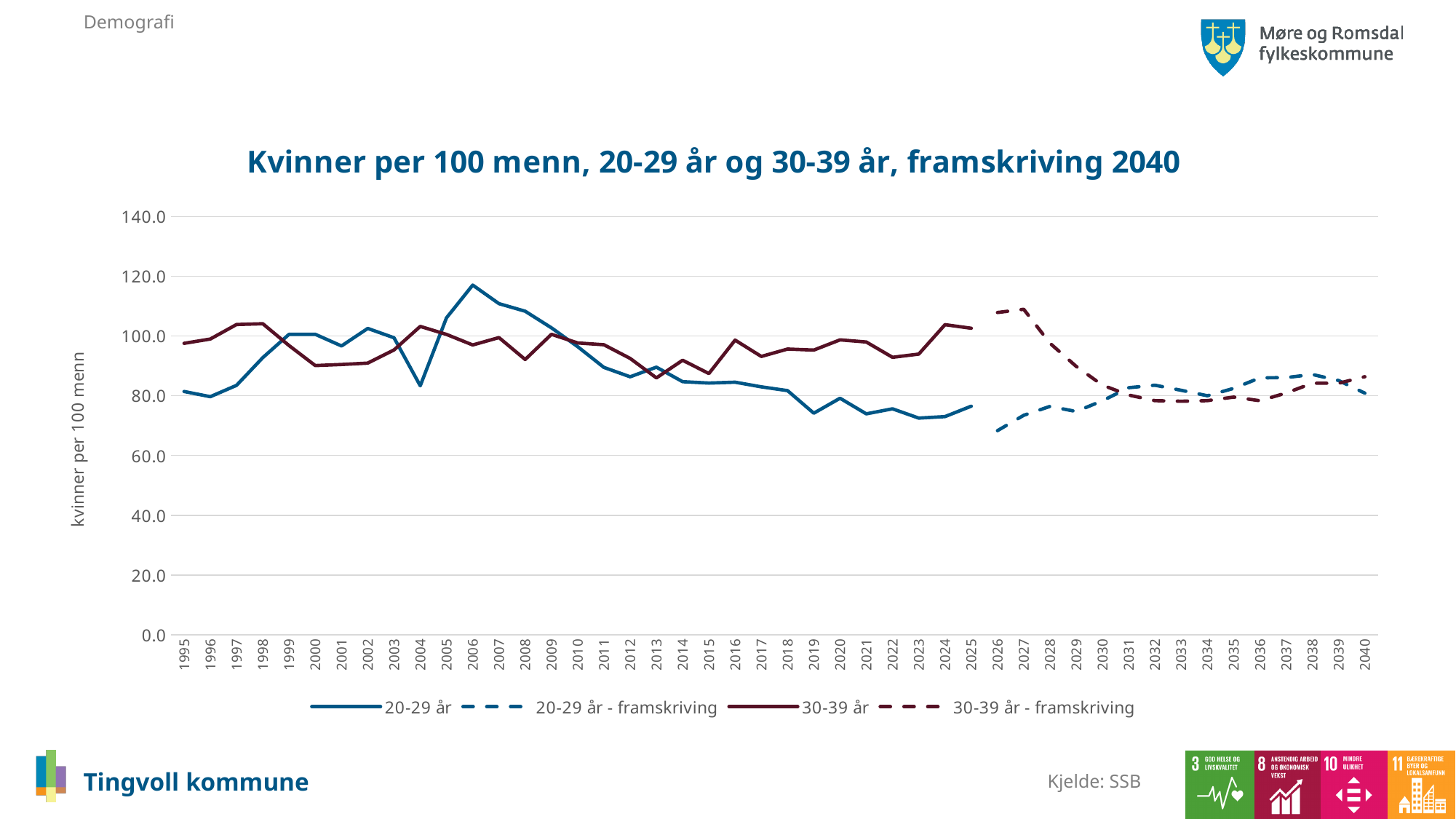
Is the value for 20-29 år in 2019 greater or less than 80? less Is the value for 20-29 år in 2006 greater or less than 100? greater How many years are shown along the x axis, from 1995 to 2040? 46 What is the title of the chart? Kvinner per 100 menn, 20-29 år og 30-39 år, framskriving 2040 In which year does the 20-29 år series reach its highest value? 2006 How many series does the legend list? 4 What is the label on the vertical axis? kvinner per 100 menn What kind of chart is shown on the slide? line chart Does the 20-29 år series rise or fall between 2006 and 2019? fall Is the value for 20-29 år - framskriving in 2026 greater or less than 80? less In 2019, which series has the higher value, 20-29 år or 30-39 år? 30-39 år